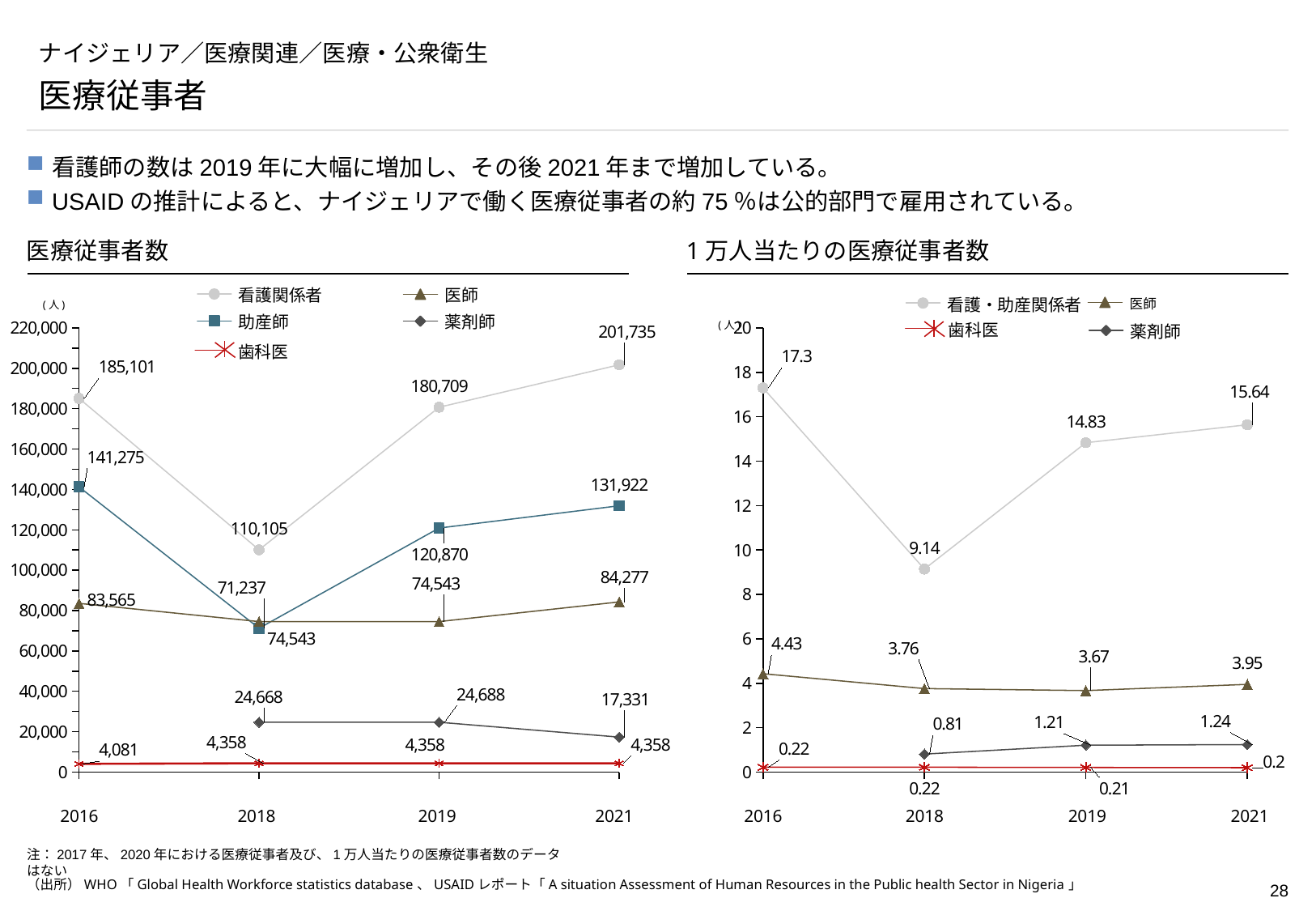
In the 医療従事者数 chart on the left, how many series does the legend list? 5 In the 医療従事者数 chart on the left, what is the difference between the 看護関係者 values in 2021 and 2019? 21,026 In the 1万人当たりの医療従事者数 chart on the right, in which year is the 医師 value highest? 2016 In the 1万人当たりの医療従事者数 chart on the right, what is the value for 薬剤師 in 2019? 1.21 In the 医療従事者数 chart on the left, which is larger in 2021: 医師 or 薬剤師? 医師 In the 医療従事者数 chart on the left, in which year is the 看護関係者 value lowest? 2018 What kind of chart is the 1万人当たりの医療従事者数 chart on the right? Line chart In the 医療従事者数 chart on the left, what is the value for 看護関係者 in 2021? 201,735 In the 1万人当たりの医療従事者数 chart on the right, does the 看護・助産関係者 value rise or fall from 2018 to 2021? Rise In the 医療従事者数 chart on the left, what is the value for 助産師 in 2018? 71,237 In the 1万人当たりの医療従事者数 chart on the right, how many years are shown on the x axis? 4 In the 1万人当たりの医療従事者数 chart on the right, what is the value for 看護・助産関係者 in 2016? 17.3